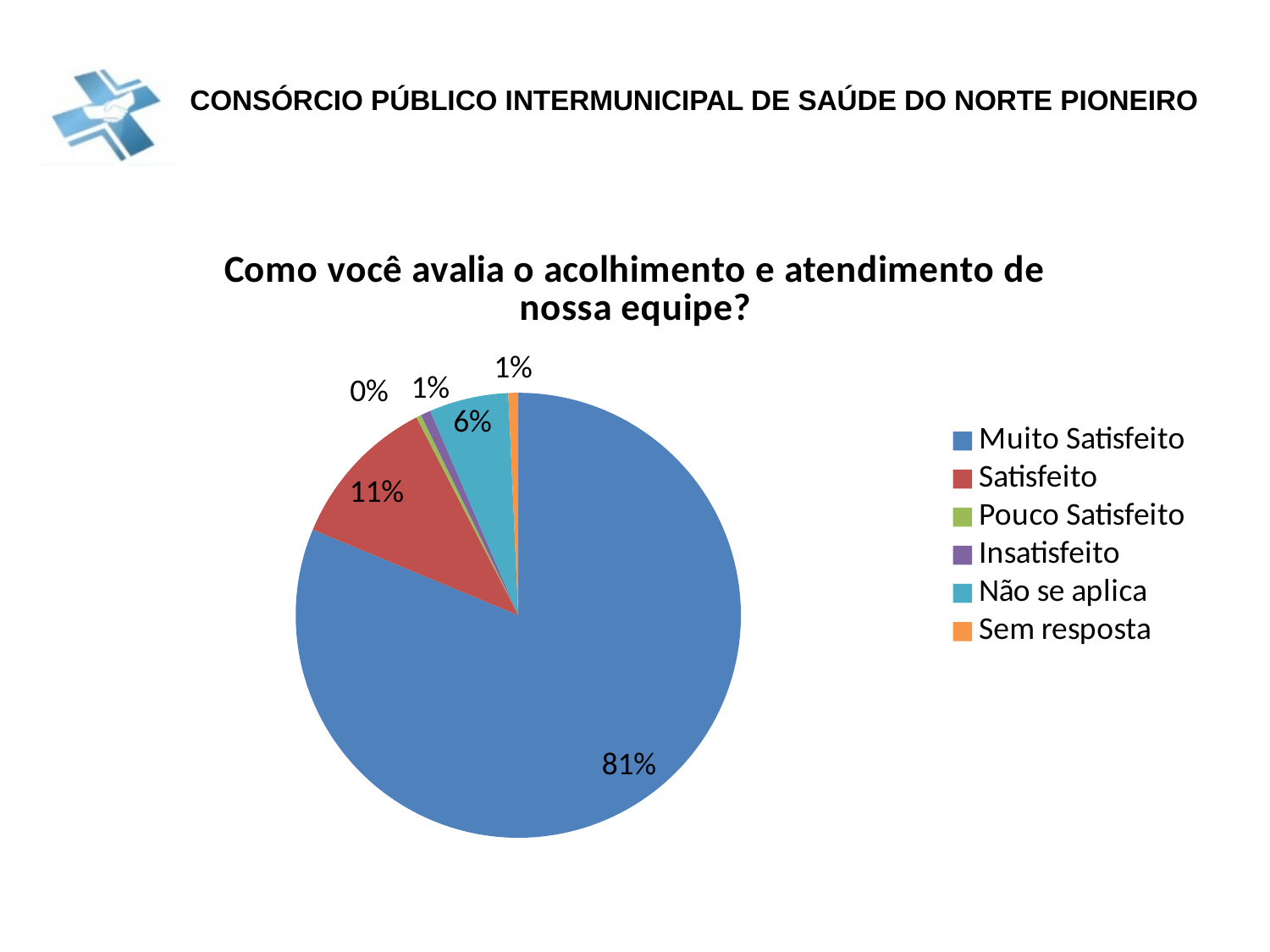
What share of the pie is labelled for Satisfeito? 11% What share of the pie is labelled for Pouco Satisfeito? 0% Which is larger, the share for Satisfeito or the share for Não se aplica? Satisfeito What share of the pie is labelled for Muito Satisfeito? 81% What is the difference in percentage points between Muito Satisfeito and Satisfeito? 70 Which category has the largest slice of the pie? Muito Satisfeito What kind of chart is shown on the slide? pie chart What is the title of the chart? Como você avalia o acolhimento e atendimento de nossa equipe? Which category has the smallest slice of the pie? Pouco Satisfeito How many categories does the legend list? 6